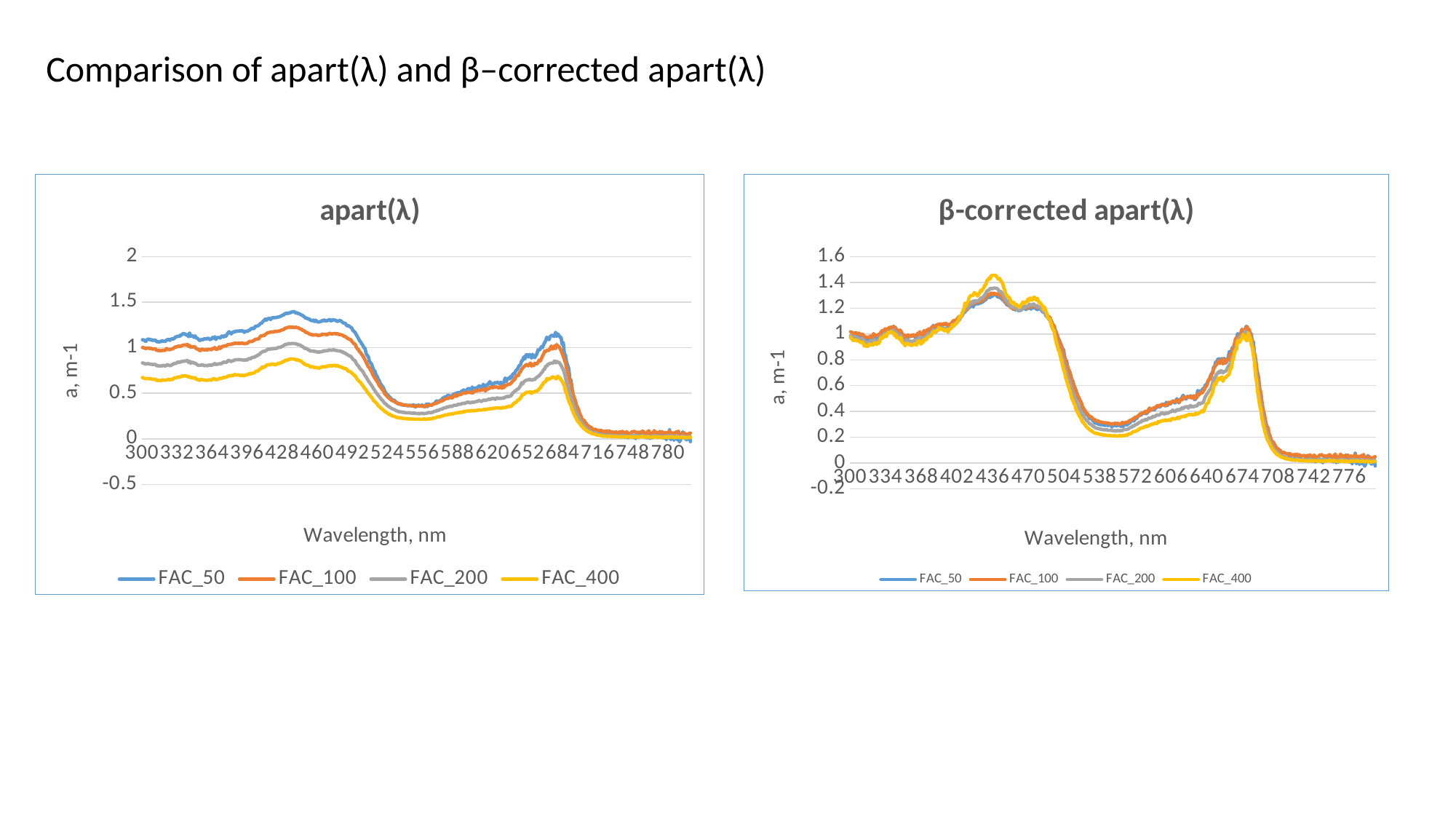
In the "apart(λ)" chart, which is larger at 652 nm: FAC_50 or FAC_400? FAC_50 What is the y-axis label of the "β-corrected apart(λ)" chart? a, m-1 In the "apart(λ)" chart, do the values rise or fall between 492 nm and 556 nm? fall In the "apart(λ)" chart, is the value of FAC_400 at 428 nm greater or less than 1? less In the "β-corrected apart(λ)" chart, is the value of FAC_400 at 572 nm greater or less than 0.4? less In the "apart(λ)" chart, which series has the lowest value at 300 nm? FAC_400 In the "apart(λ)" chart, which series has the highest value at 428 nm? FAC_50 What is the x-axis label of the "apart(λ)" chart? Wavelength, nm What kind of chart is the chart titled "apart(λ)"? line chart In the "β-corrected apart(λ)" chart, is the peak value of FAC_400 near 436 nm greater or less than 1.2? greater How many series does the legend of the "β-corrected apart(λ)" chart list? 4